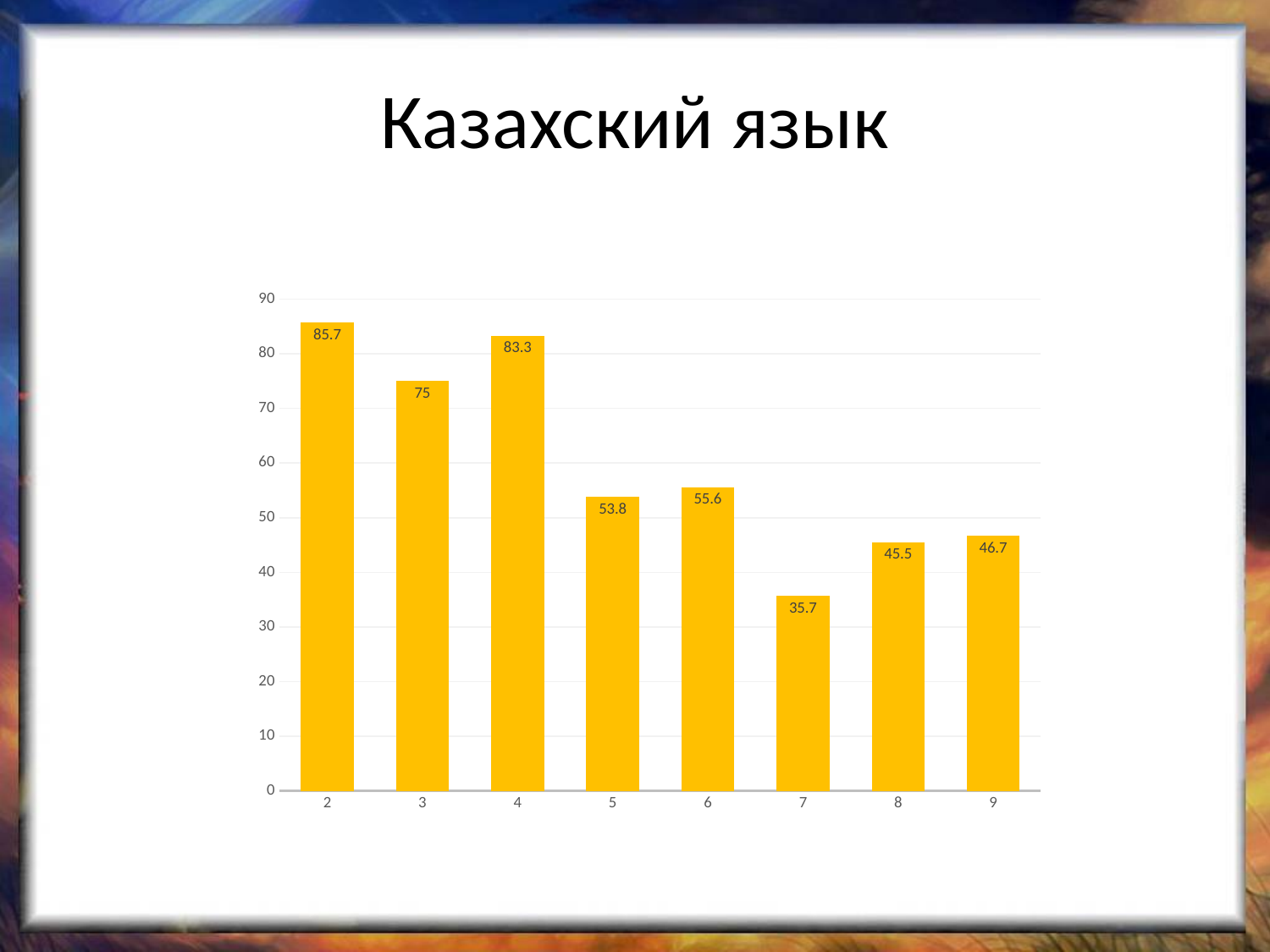
What is the difference between the values for category 3 and category 4? 8.3 What is the difference between the values for category 2 and category 7? 50 What is the value for category 7? 35.7 Which category has the highest value? 2 Which is larger, the value for category 6 or the value for category 9? 6 What is the value for category 2? 85.7 What is the value for category 5? 53.8 How many categories are shown on the x axis? 8 Which category has the lowest value? 7 Is the value for category 8 greater or less than 50? less What kind of chart is shown on the slide? bar chart What is the title of the slide? Казахский язык